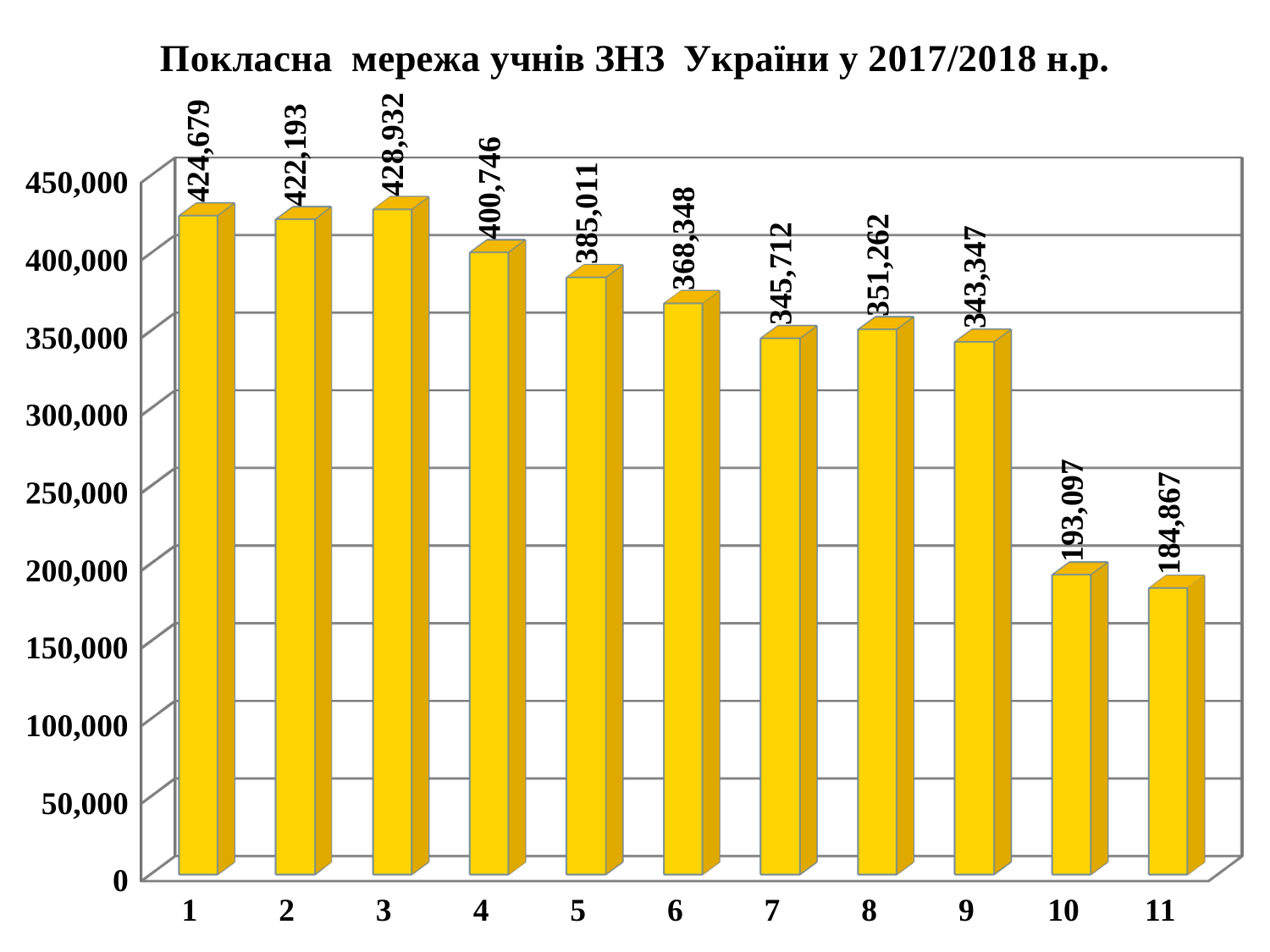
Which is larger, the value for grade 8 or grade 9? grade 8 What is the value for grade 10? 193,097 Which grade has the lowest value? 11 What type of chart is shown on the slide? bar chart What is the difference between the values for grade 10 and grade 11? 8,230 What is the value for grade 6? 368,348 What is the value for grade 1? 424,679 How many categories (grades) are shown on the x axis? 11 What is the difference between the values for grade 8 and grade 7? 5,550 Which grade has the highest value? 3 What is the title of the chart? Покласна мережа учнів ЗНЗ України у 2017/2018 н.р. Is the value for grade 5 greater or less than 400,000? less